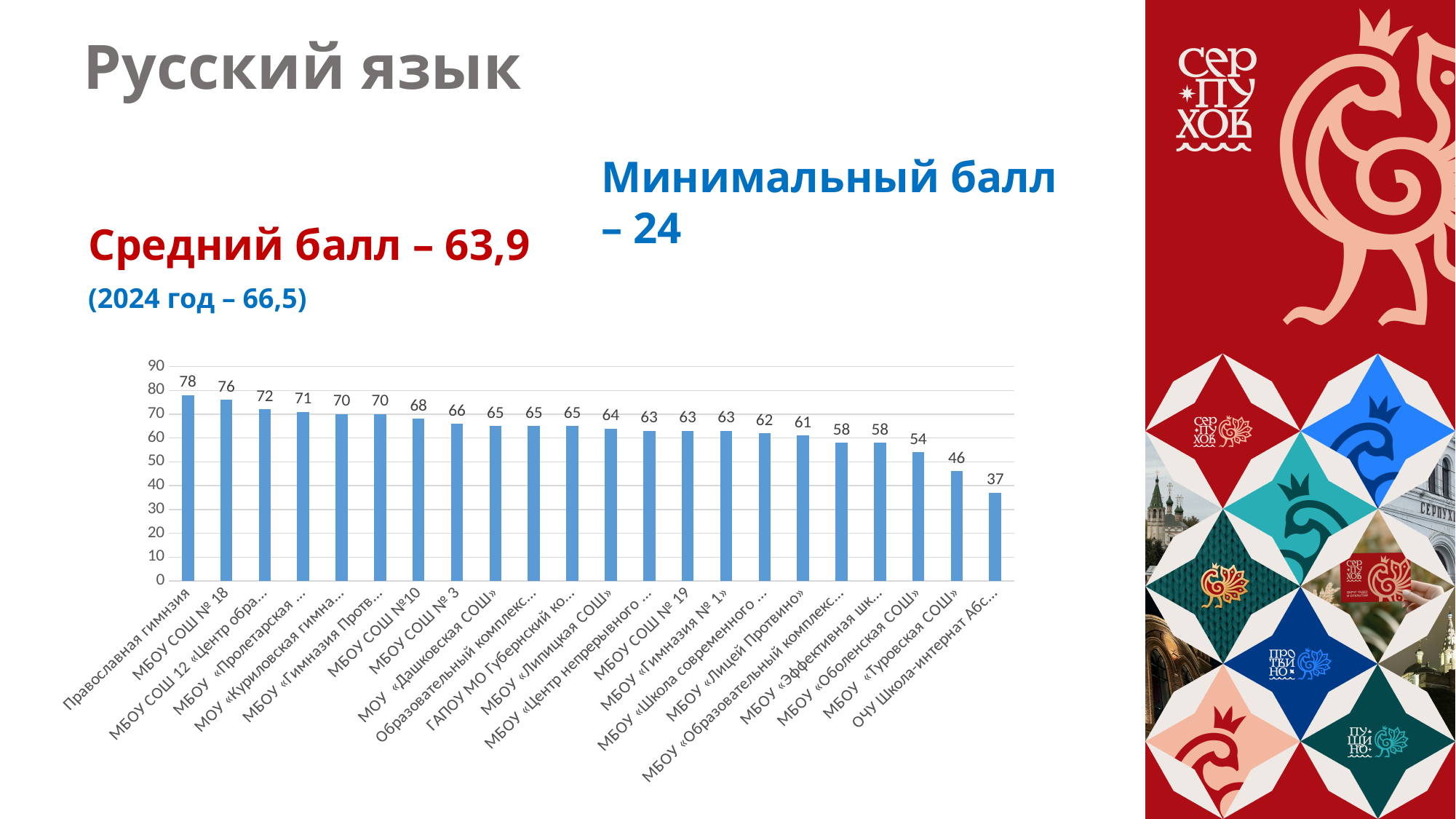
Which category has the highest value? Православная гимназия What is the lowest value shown in the chart? 37 What is the difference between the values for МБОУ СОШ № 18 and МБОУ «Туровская СОШ»? 30 What is the value for МБОУ СОШ № 18? 76 What is the value for МБОУ СОШ №10? 68 Do the values rise or fall from left to right along the x axis? fall What is the value for Православная гимназия? 78 What is the value for МБОУ «Лицей Протвино»? 61 What type of chart is shown on the slide? bar chart Which is larger, the value for МБОУ «Лицей Протвино» or МБОУ «Оболенская СОШ»? МБОУ «Лицей Протвино» What is the value for МБОУ «Туровская СОШ»? 46 How many bars are in the chart? 22